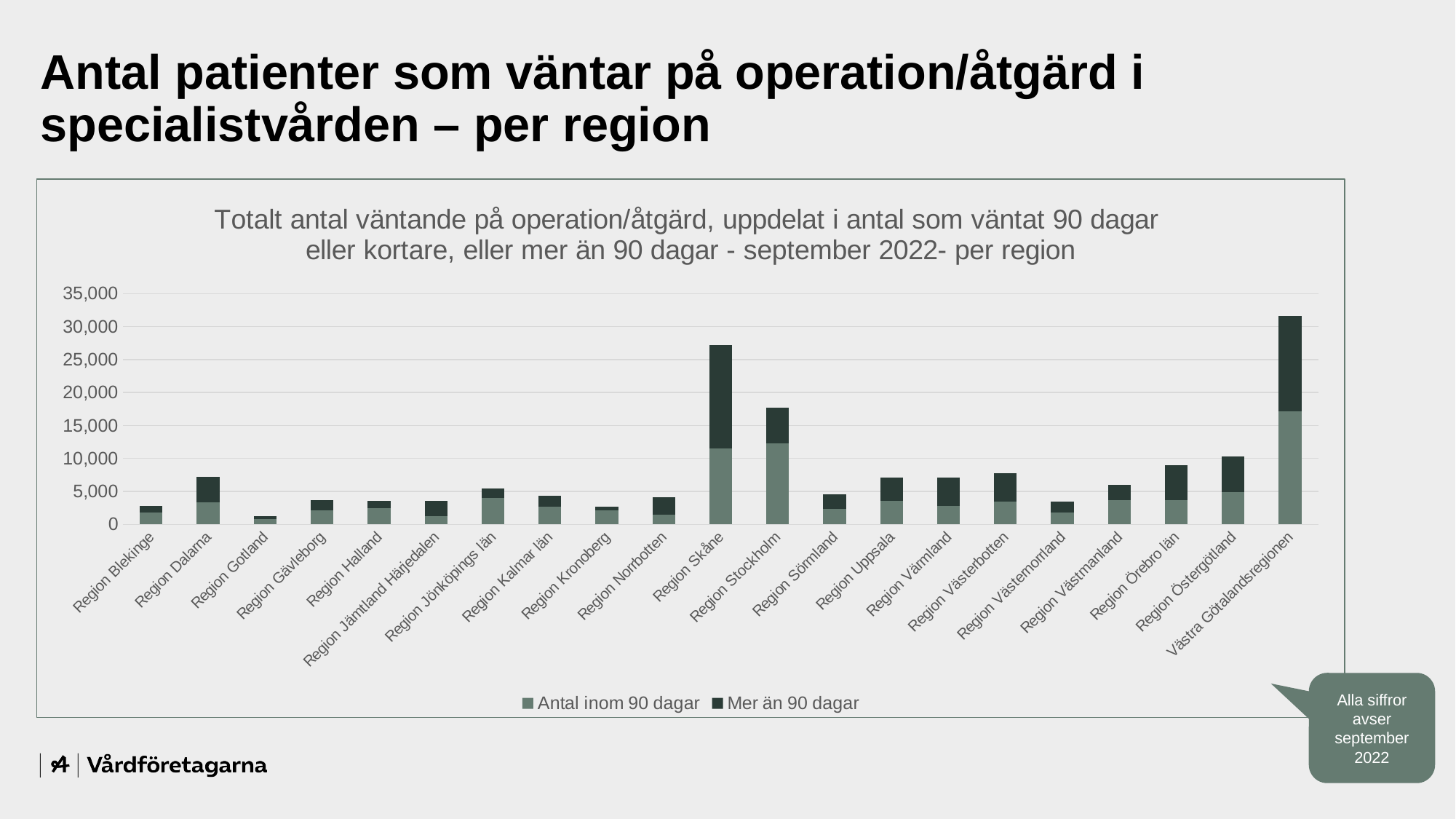
Which has a larger total bar, Region Dalarna or Region Gotland? Region Dalarna What kind of chart is shown on the slide? Stacked bar chart Is the total value for Region Stockholm greater or less than 15,000? greater How many series does the legend list? 2 What are the two legend entries of the chart? Antal inom 90 dagar; Mer än 90 dagar Which region has the lowest total number of waiting patients? Region Gotland How many regions are shown on the x axis? 21 Which has a larger total bar, Region Skåne or Region Stockholm? Region Skåne Is the total value for Region Örebro län greater or less than 10,000? less Is the total value for Region Gotland greater or less than 5,000? less Which region has the highest total number of waiting patients? Västra Götalandsregionen